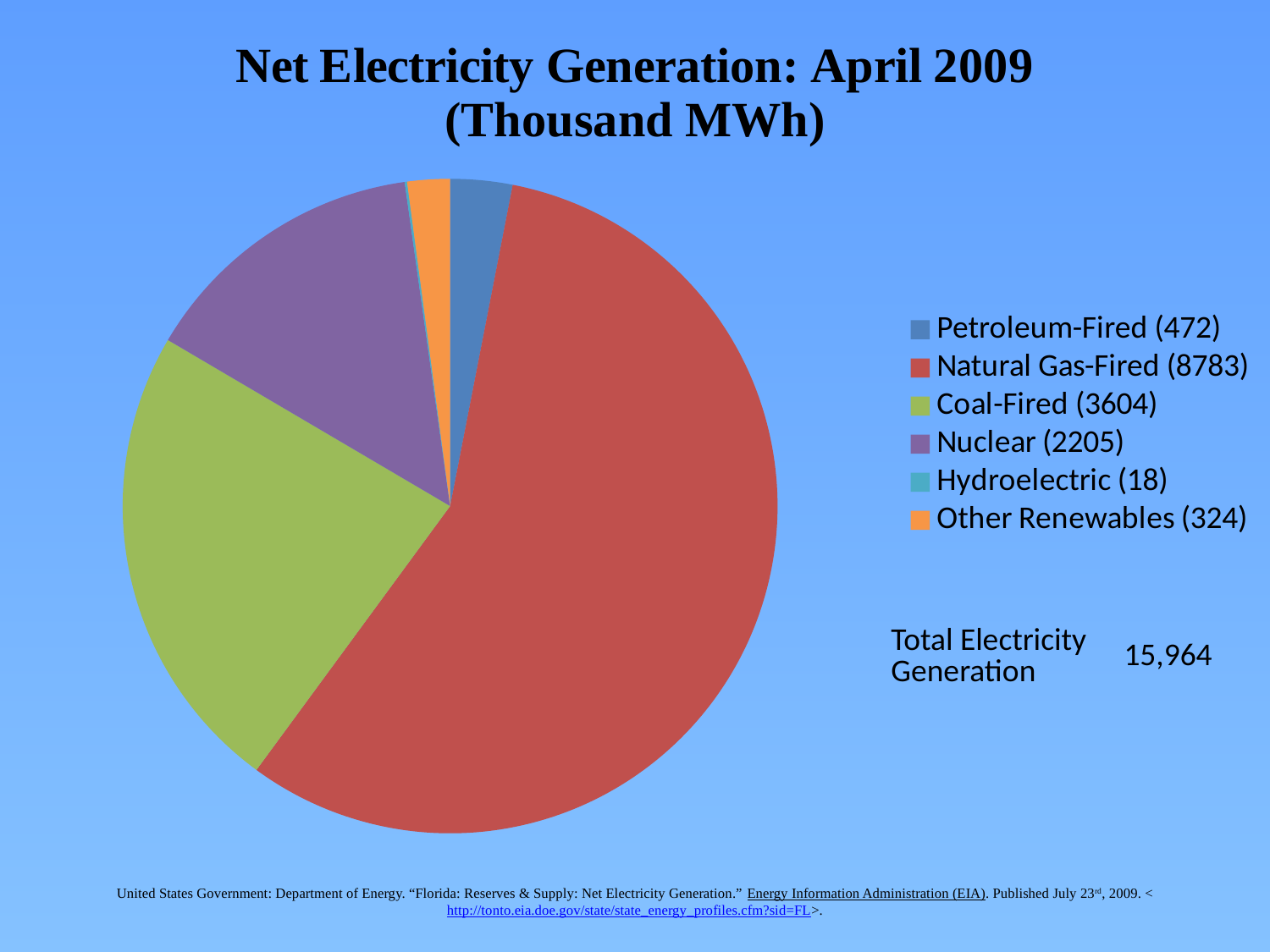
What is the value for Hydroelectric generation? 18 Which category has the largest share of the pie? Natural Gas-Fired What is the title of the chart? Net Electricity Generation: April 2009 (Thousand MWh) How many categories does the pie chart have? 6 What is the difference between Natural Gas-Fired and Coal-Fired generation? 5179 Which category has the smallest share of the pie? Hydroelectric What is the value for Coal-Fired generation? 3604 What is the value for Natural Gas-Fired generation? 8783 What kind of chart is shown on the slide? pie chart What is the total electricity generation shown on the slide? 15,964 Which is larger, Coal-Fired or Nuclear generation? Coal-Fired What is the difference between Petroleum-Fired and Other Renewables generation? 148